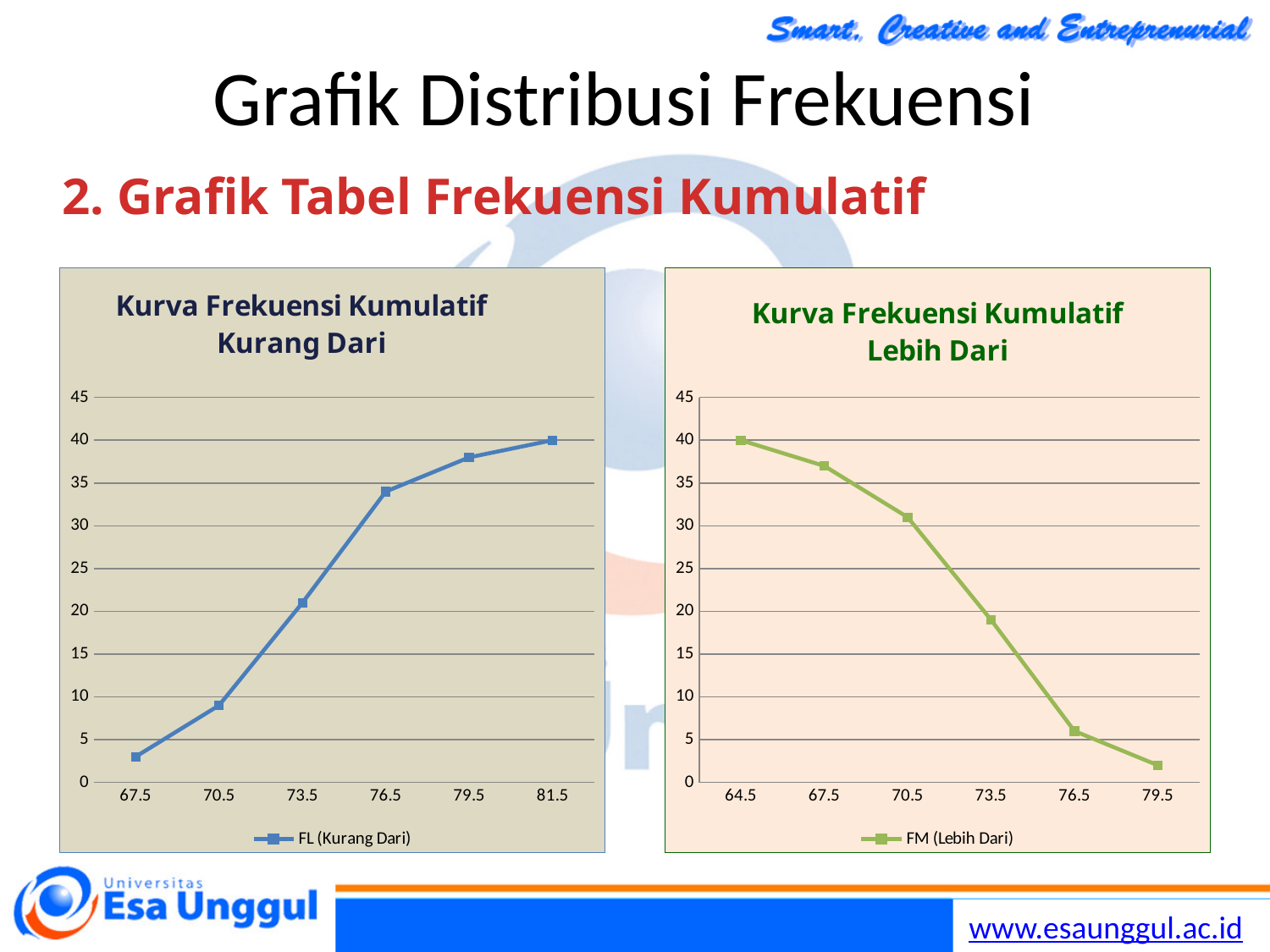
In the 'Kurva Frekuensi Kumulatif Kurang Dari' chart, which x-axis value has the lowest plotted value? 67.5 In the 'Kurva Frekuensi Kumulatif Lebih Dari' chart, what is the value at 64.5? 40 In the 'Kurva Frekuensi Kumulatif Lebih Dari' chart, is the value at 70.5 greater or less than 30? greater How many data points are plotted in the 'Kurva Frekuensi Kumulatif Lebih Dari' chart? 6 What type of chart is the 'Kurva Frekuensi Kumulatif Kurang Dari' chart on the left? line chart In the 'Kurva Frekuensi Kumulatif Lebih Dari' chart, is the value at 73.5 greater or less than 20? less What is the legend entry of the 'Kurva Frekuensi Kumulatif Lebih Dari' chart? FM (Lebih Dari) In the 'Kurva Frekuensi Kumulatif Kurang Dari' chart, what is the value at 81.5? 40 In the 'Kurva Frekuensi Kumulatif Lebih Dari' chart, do the values rise or fall as the x-axis values increase? fall In the 'Kurva Frekuensi Kumulatif Kurang Dari' chart, do the values rise or fall as the x-axis values increase? rise In the 'Kurva Frekuensi Kumulatif Kurang Dari' chart, is the value at 73.5 greater or less than 20? greater